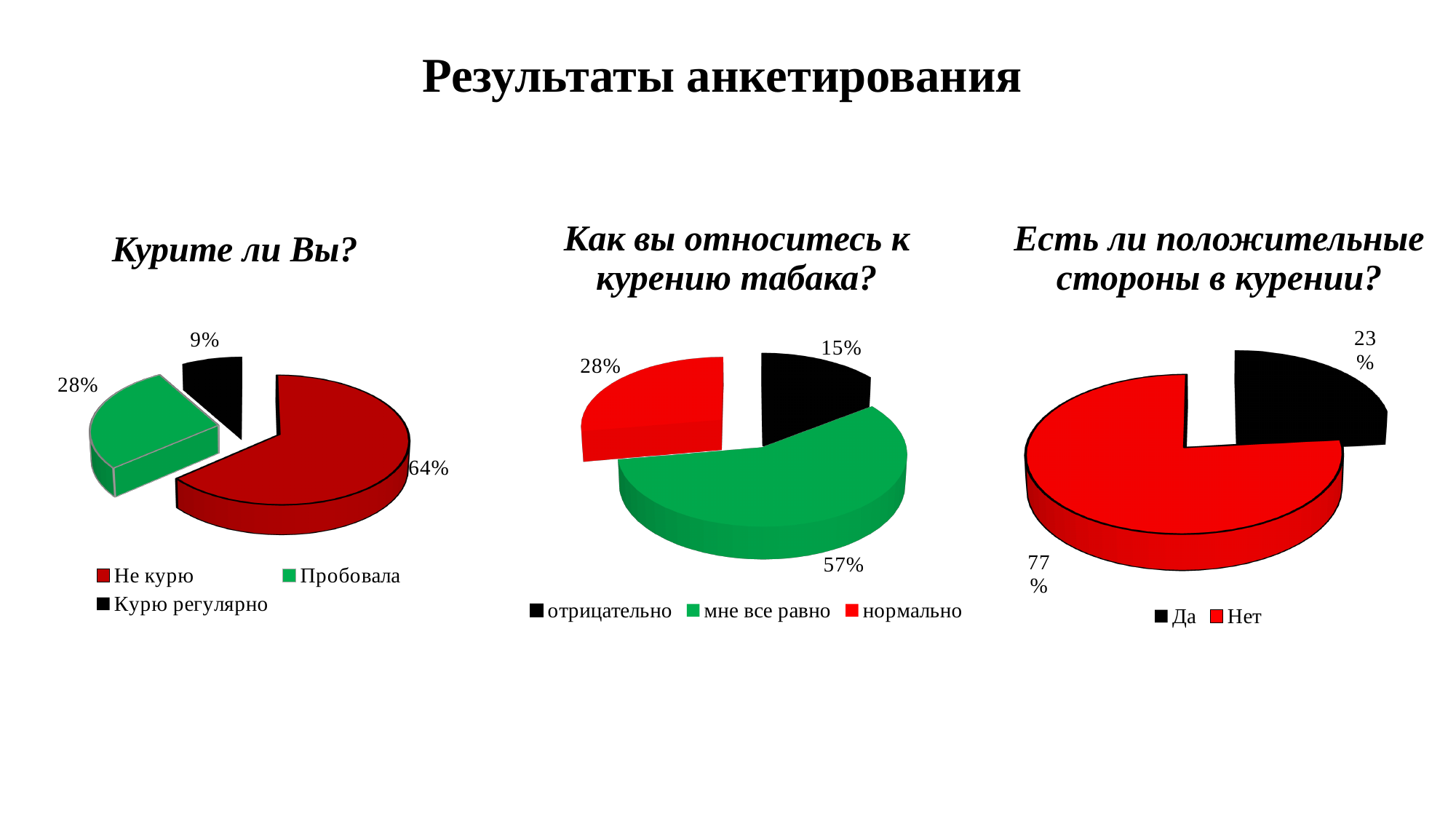
In the chart titled "Курите ли Вы?", what colour is the "Пробовала" slice? Green In the chart titled "Курите ли Вы?", what percentage is shown for "Не курю"? 64% In the chart titled "Есть ли положительные стороны в курении?", what is the difference in percentage points between "Нет" and "Да"? 54 In the chart titled "Как вы относитесь к курению табака?", what percentage is shown for "мне все равно"? 57% In the chart titled "Как вы относитесь к курению табака?", which category has the smallest slice? отрицательно What kind of chart is used for "Есть ли положительные стороны в курении?"? Pie chart In the chart titled "Как вы относитесь к курению табака?", what is the difference in percentage points between "мне все равно" and "нормально"? 29 In the chart titled "Курите ли Вы?", what percentage is shown for "Курю регулярно"? 9% In the chart titled "Есть ли положительные стороны в курении?", what percentage is shown for "Нет"? 77% In the chart titled "Курите ли Вы?", how many categories does the legend list? 3 In the chart titled "Курите ли Вы?", which category has the largest slice? Не курю In the chart titled "Как вы относитесь к курению табака?", which is larger: "нормально" or "отрицательно"? нормально